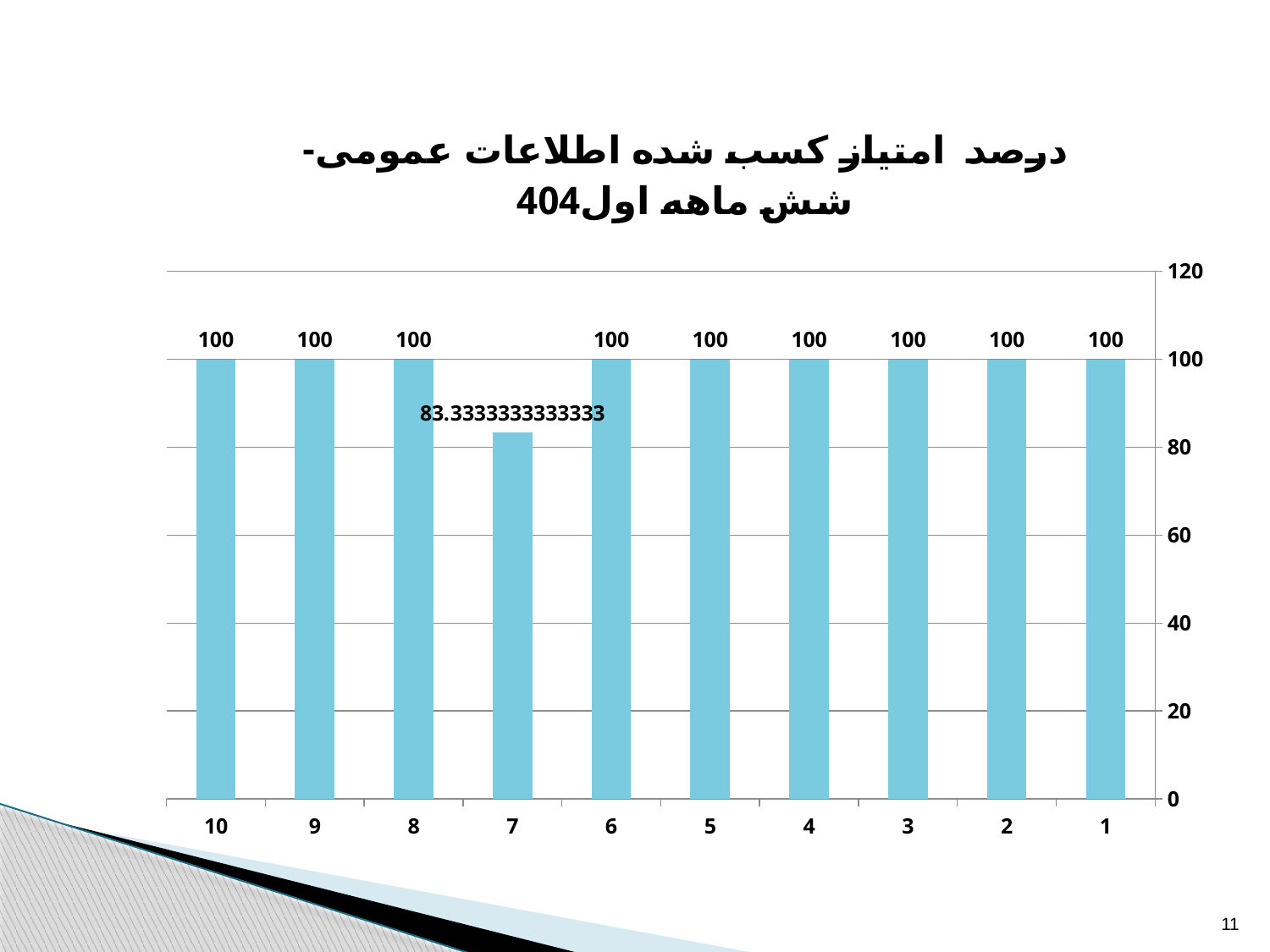
What is the value for category 1? 100 Which category has the lowest value? 7 What is the highest value shown on the vertical axis? 120 How many categories are shown on the x axis? 10 What colour are the bars in the chart? light blue What is the value for category 7? 83.3333333333333 How many categories have a value of 100? 9 Which is larger, the value for category 6 or the value for category 7? category 6 What is the difference between the value for category 8 and the value for category 7? 16.6666666666667 What is the value for category 10? 100 What kind of chart is shown on the slide? bar chart Is the value for category 7 greater or less than 80? greater